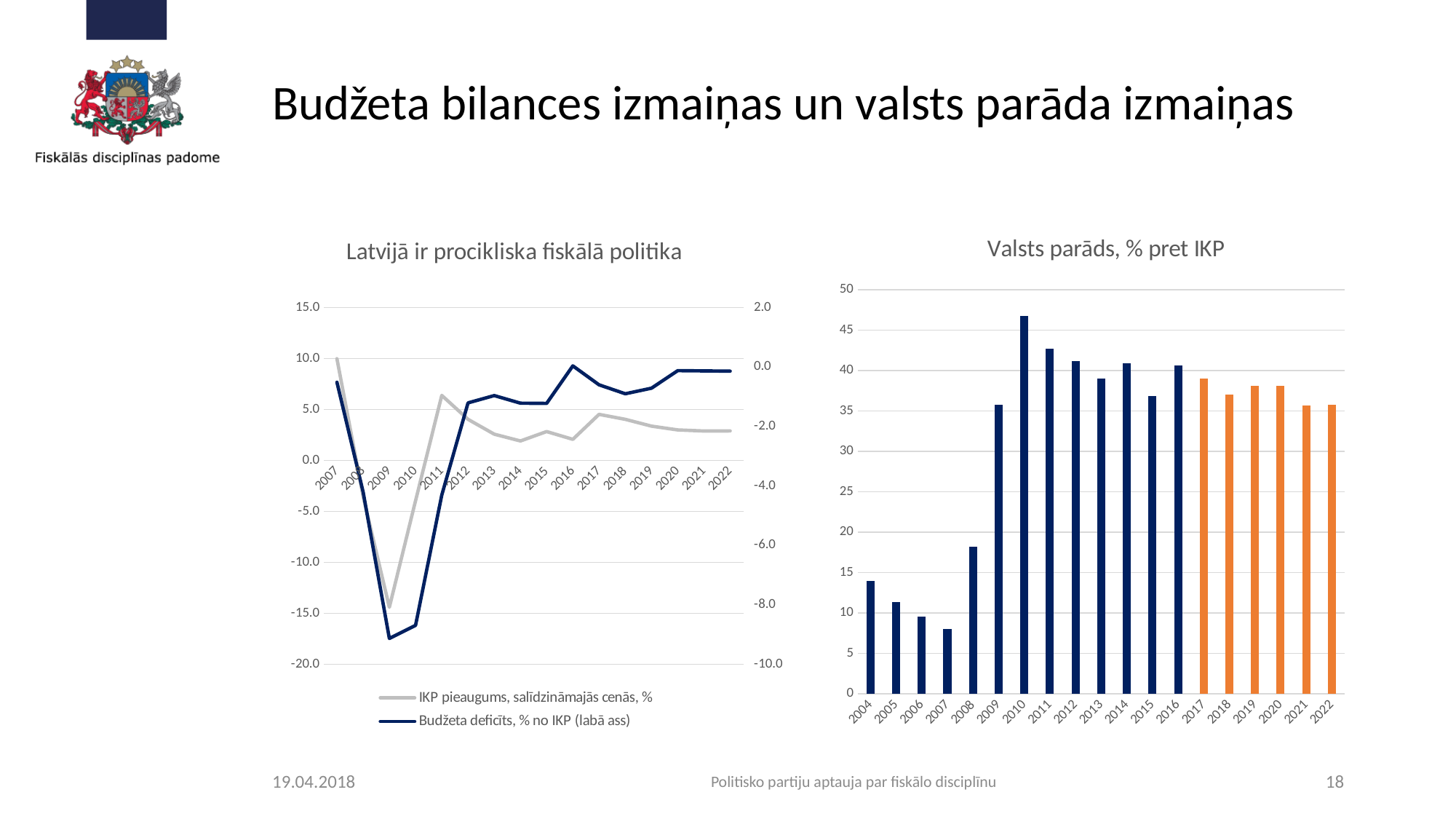
On the chart titled "Valsts parāds, % pret IKP", which year has the lowest value? 2007 On the chart titled "Valsts parāds, % pret IKP", what colour are the bars for 2017 to 2022? orange On the chart titled "Latvijā ir procikliska fiskālā politika", in which year does the series "IKP pieaugums, salīdzināmajās cenās, %" reach its lowest value? 2009 On the chart titled "Valsts parāds, % pret IKP", which is larger, the value for 2008 or the value for 2009? 2009 On the chart titled "Valsts parāds, % pret IKP", what kind of chart is it? bar chart On the chart titled "Valsts parāds, % pret IKP", is the value for 2013 greater or less than 40? less On the chart titled "Valsts parāds, % pret IKP", is the value for 2007 greater or less than 10? less On the chart titled "Latvijā ir procikliska fiskālā politika", is the value of "IKP pieaugums, salīdzināmajās cenās, %" for 2007 greater or less than 5.0? greater On the chart titled "Valsts parāds, % pret IKP", which year has the highest value? 2010 On the chart titled "Valsts parāds, % pret IKP", how many years are shown on the x axis? 19 On the chart titled "Latvijā ir procikliska fiskālā politika", how many series does the legend list? 2